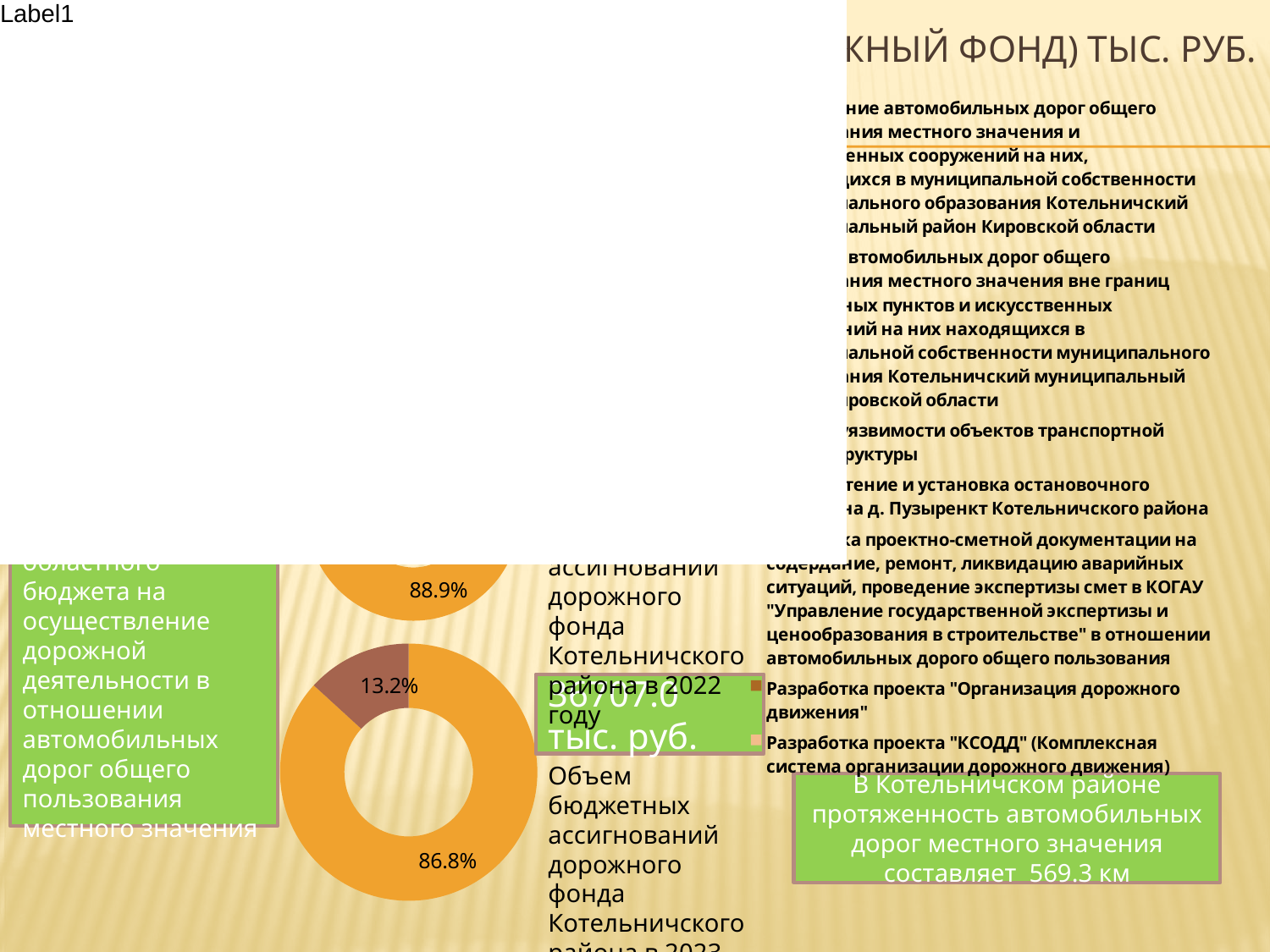
In the lower doughnut chart, what do the two labelled slices (86.8% and 13.2%) add up to? 100% What is the difference between the 88.9% slice in the upper doughnut chart and the 86.8% slice in the lower doughnut chart? 2.1 percentage points Which is larger: the labelled orange slice of the upper doughnut chart (88.9%) or the orange slice of the lower doughnut chart (86.8%)? the upper chart's slice (88.9%) What kind of chart are the two charts on the left side of the slide? doughnut chart In the lower doughnut chart, what is the difference between the two labelled slices, 86.8% and 13.2%? 73.6 percentage points How many slices with printed percentage labels does the lower doughnut chart have? 2 In the lower doughnut chart, which slice is larger, the orange one or the brown one? the orange one (86.8%) In the lower doughnut chart, is the brown slice's share greater or less than 50%? less In the upper doughnut chart, what percentage is printed on the large orange slice? 88.9% What colour is the largest slice in the lower doughnut chart? orange In the lower doughnut chart, what is the value of the smallest slice? 13.2% In the lower doughnut chart, what is the value of the largest slice? 86.8%